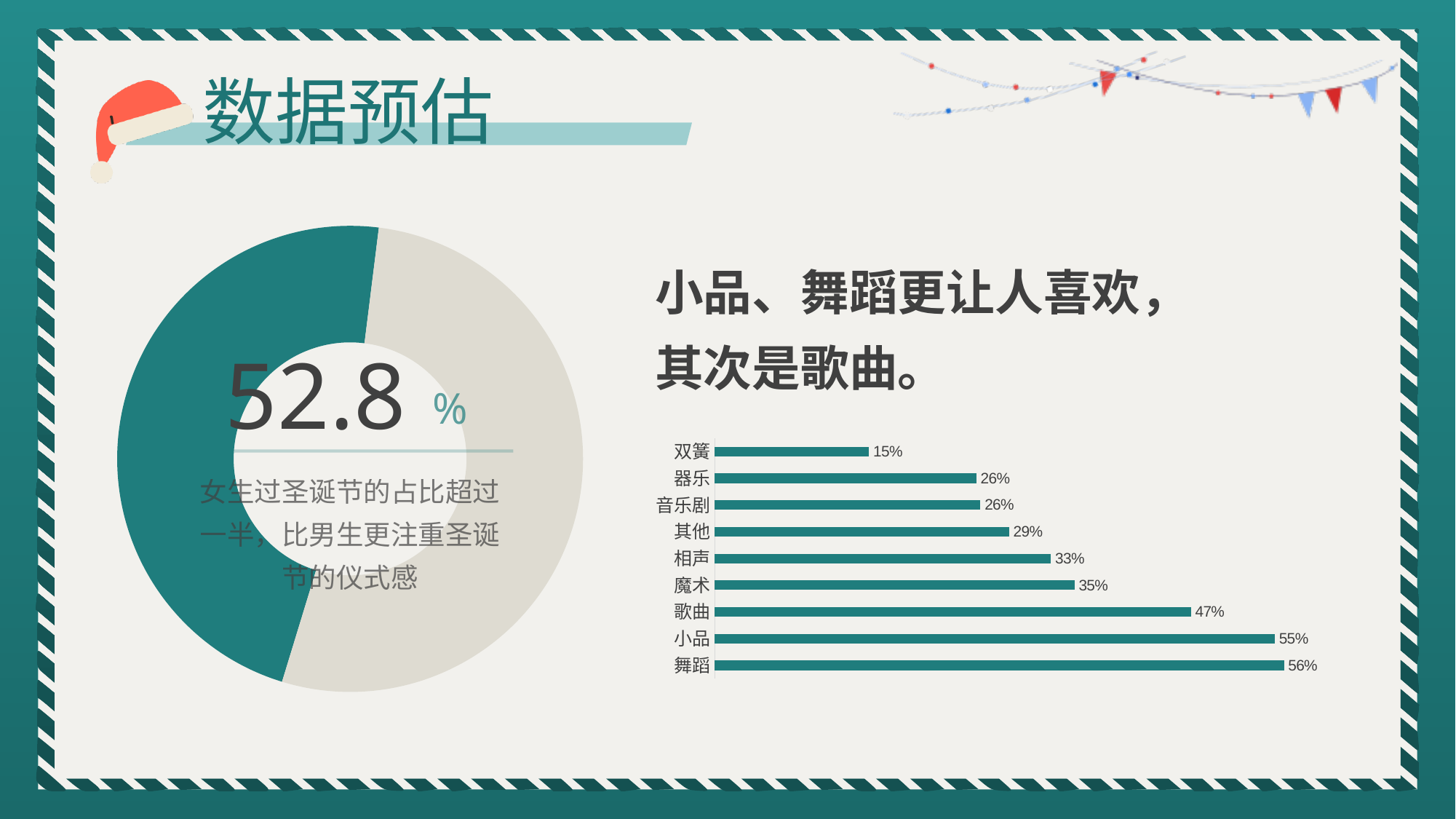
What percentage is shown in the centre of the donut chart on the left? 52.8% In the bar chart on the right, which category has the highest value? 舞蹈 In the bar chart on the right, what is the value for 歌曲? 47% What kind of chart is shown on the right side of the slide? bar chart In the bar chart on the right, which category has the lowest value? 双簧 In the bar chart on the right, what is the value for 魔术? 35% In the bar chart on the right, what is the difference between the values for 舞蹈 and 小品? 1% In the bar chart on the right, what is the value for 双簧? 15% In the bar chart on the right, what is the difference between the values for 歌曲 and 相声? 14% How many categories are shown in the bar chart on the right? 9 In the bar chart on the right, which is larger, the value for 其他 or the value for 器乐? 其他 What kind of chart is shown on the left side of the slide? donut chart